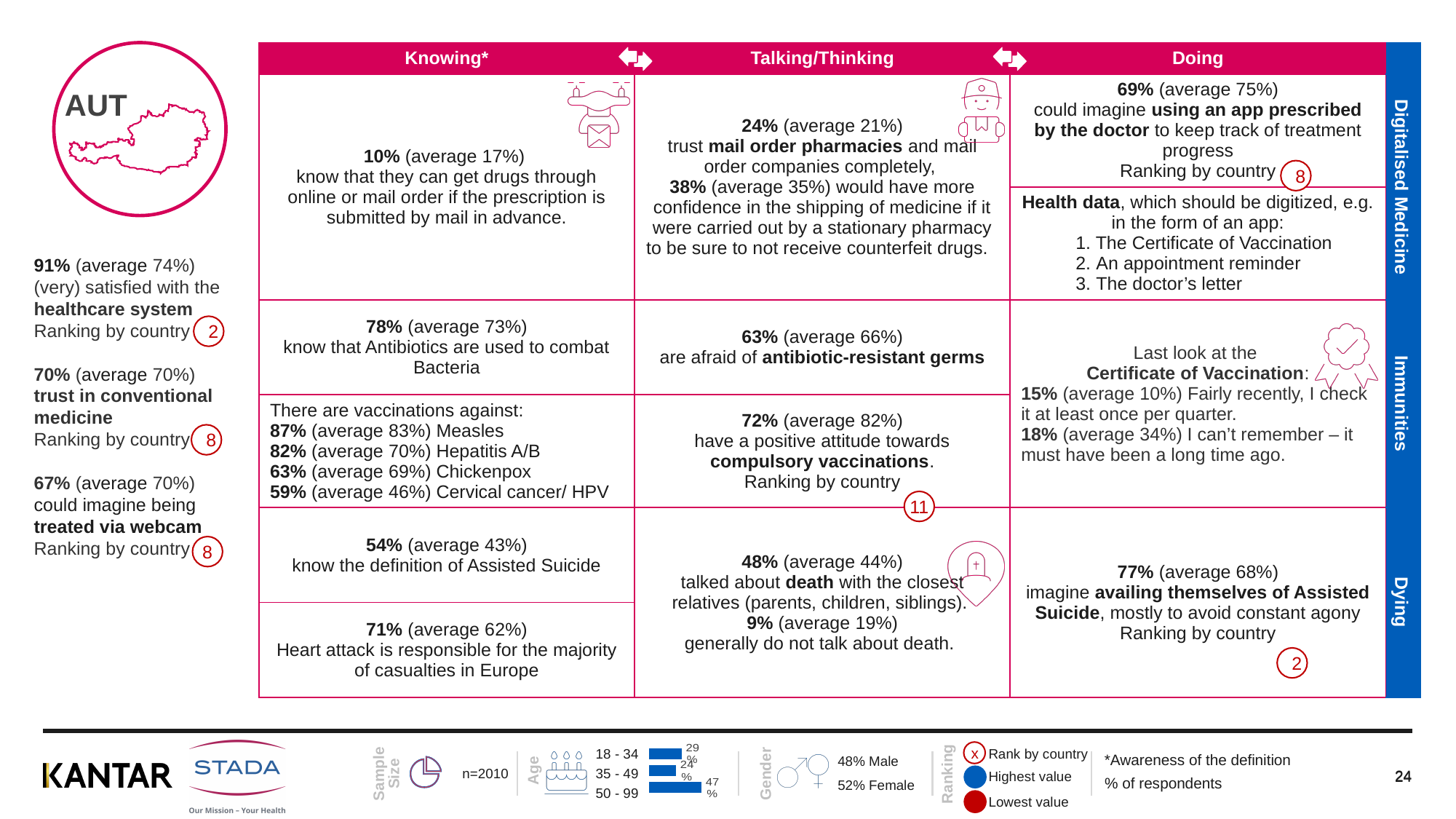
In the age bar chart at the bottom of the slide, what do the three age group values add up to? 100% In the age bar chart at the bottom of the slide, which is larger: the value for 18 - 34 or for 35 - 49? 18 - 34 In the age bar chart at the bottom of the slide, what is the value for the 35 - 49 age group? 24% What does the small bar chart at the bottom of the slide show? Age distribution of respondents What kind of chart is used to show the age distribution at the bottom of the slide? Bar chart In the age bar chart at the bottom of the slide, which age group has the lowest value? 35 - 49 In the age bar chart at the bottom of the slide, which age group has the highest value? 50 - 99 In the age bar chart at the bottom of the slide, what is the difference between the 18 - 34 and 35 - 49 age groups? 5% In the age bar chart at the bottom of the slide, what is the difference between the 50 - 99 and 18 - 34 age groups? 18% In the age bar chart at the bottom of the slide, what is the value for the 18 - 34 age group? 29% In the age bar chart at the bottom of the slide, what is the value for the 50 - 99 age group? 47% How many age groups are shown in the age bar chart at the bottom of the slide? 3